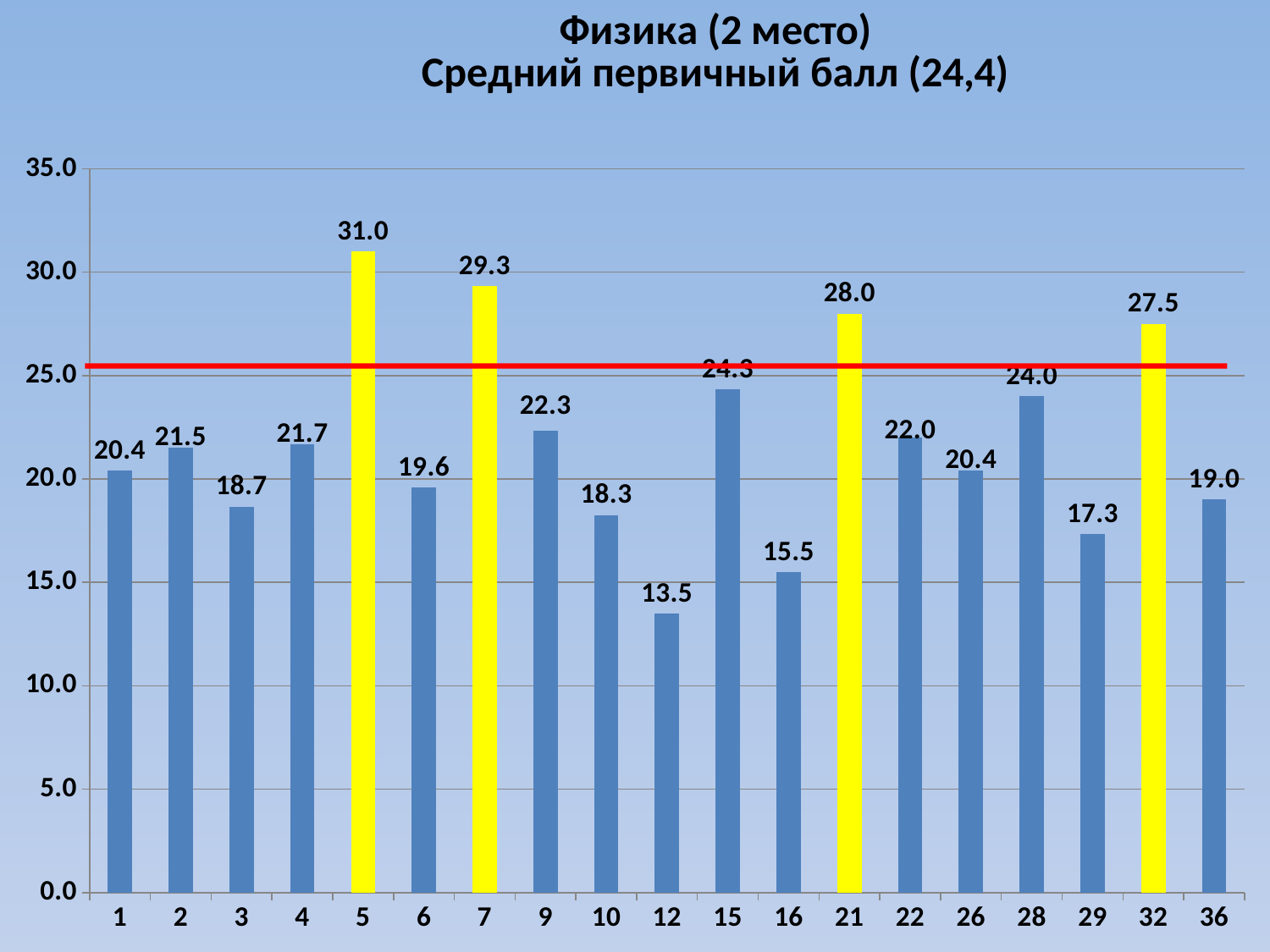
Is the value for category 32 greater or less than 25.0? greater Which category has the lowest value? 12 What is the value for category 5? 31.0 What type of chart is shown on the slide? bar chart How many bars are coloured yellow? 4 What is the difference between the values for category 21 and category 16? 12.5 How many categories are shown on the x axis? 19 What is the value for category 12? 13.5 Which is larger, the value for category 15 or the value for category 28? 15 What is the value for category 29? 17.3 Which category has the highest value? 5 What is the difference between the values for category 5 and category 7? 1.7